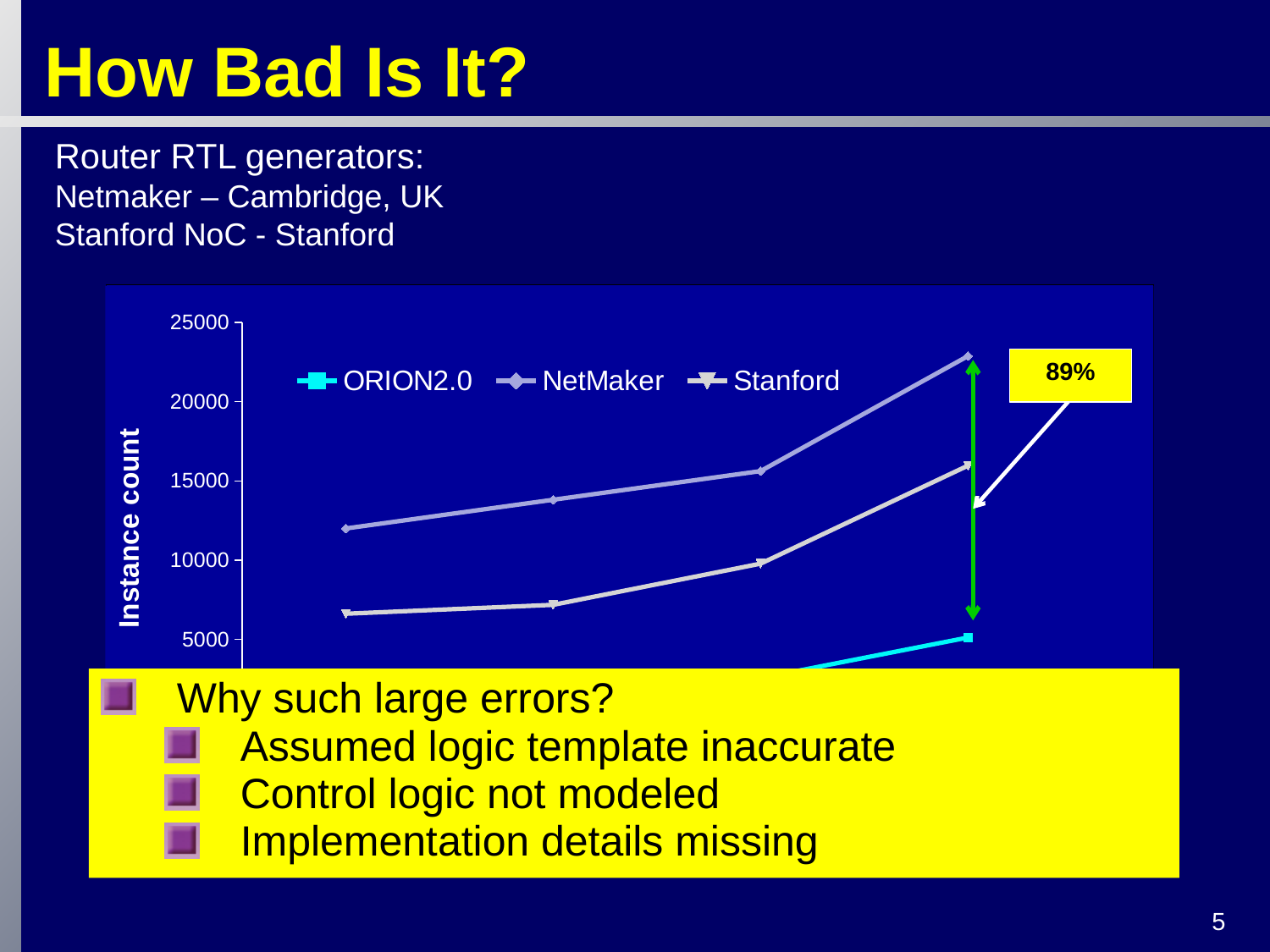
What is the label on the vertical axis of the chart? Instance count How many series does the chart legend list? 3 At the rightmost point, which series has the larger instance count, NetMaker or Stanford? NetMaker Is the rightmost NetMaker value greater or less than 20000? greater Which series has the highest instance count at the rightmost point? NetMaker What kind of chart is shown on the slide? line chart Is the leftmost NetMaker value greater or less than 10000? greater Is the rightmost Stanford value greater or less than 20000? less Do the Stanford values rise or fall from left to right along the x axis? rise Do the NetMaker values rise or fall from left to right along the x axis? rise Which series has the lowest instance count at the rightmost point? ORION2.0 Which series are listed in the chart legend? ORION2.0, NetMaker, Stanford